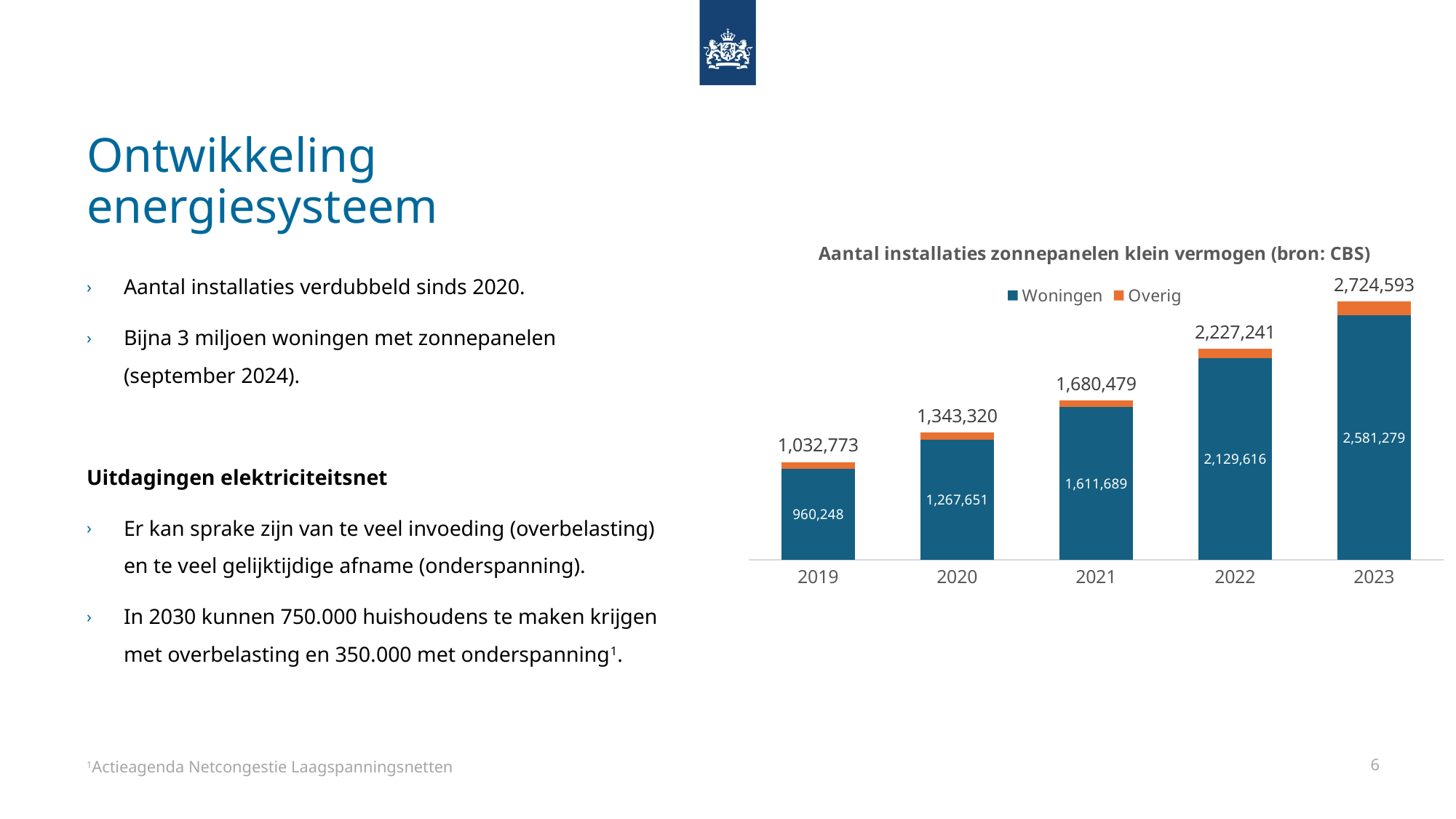
How many years are shown on the x axis of the chart? 5 What is the total number of installations shown above the bar for 2020? 1,343,320 How many series does the chart legend list? 2 Based on the printed total and Woningen labels, what is the Overig value for 2019? 72,525 Do the total installation values rise or fall from 2019 to 2023? Rise What is the Woningen value for 2021? 1,611,689 Is the total for 2022 larger than the total for 2021? Yes What is the difference between the Woningen values for 2023 and 2022? 451,663 Which year has the highest total number of installations? 2023 Which year has the lowest Woningen value? 2019 What is the title of the chart? Aantal installaties zonnepanelen klein vermogen (bron: CBS) What type of chart is shown on the slide? Stacked bar chart